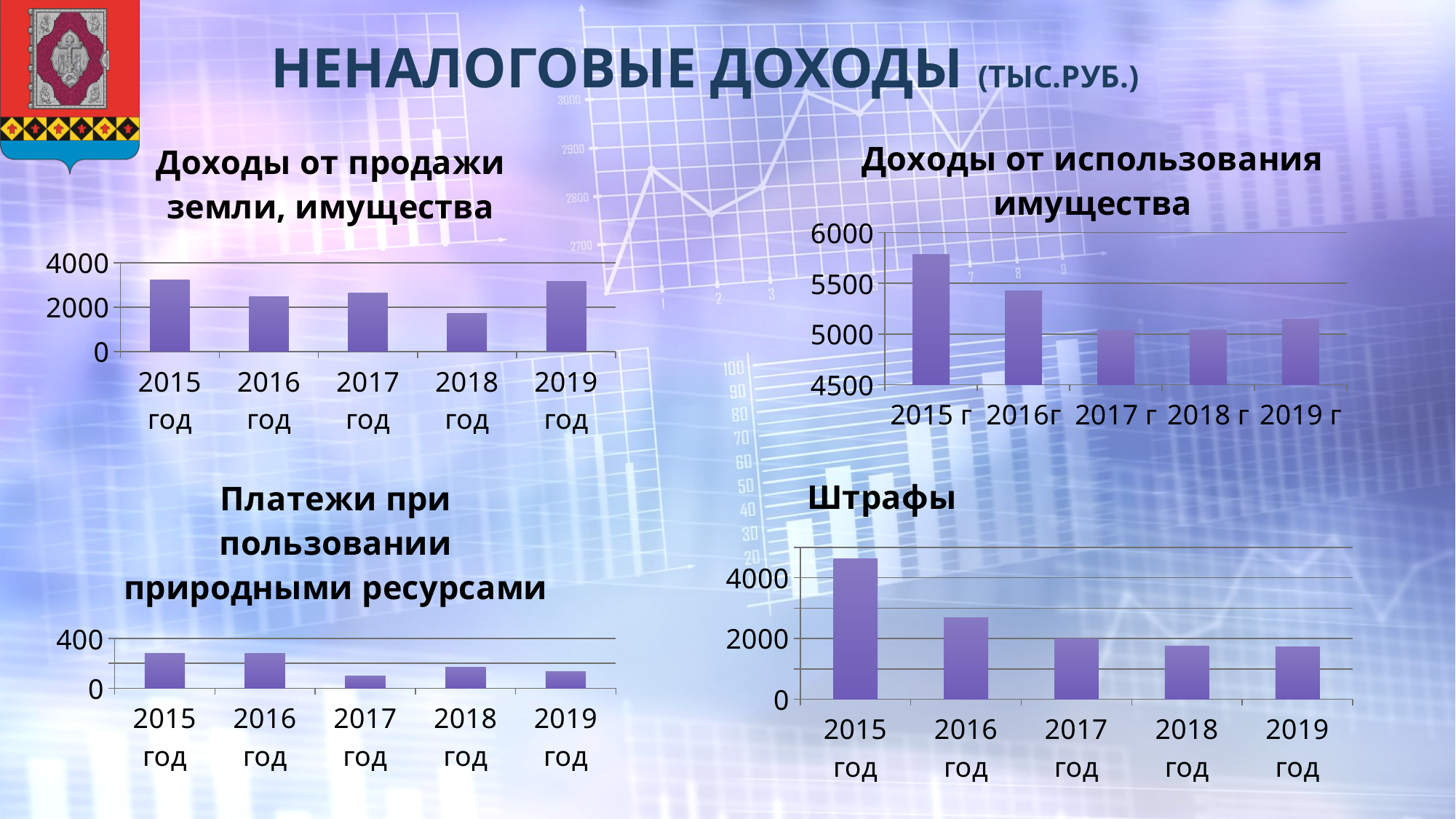
In the 'Доходы от использования имущества' chart, is the value for 2015 г greater or less than 5500? greater In the 'Доходы от использования имущества' chart, which year has the highest value? 2015 г In the 'Доходы от использования имущества' chart, which is larger, the value for 2016г or for 2019 г? 2016г What kind of chart is the 'Штрафы' chart? bar chart In the 'Штрафы' chart, is the value for 2018 год greater or less than 2000? less How many years are shown on the x axis of the 'Штрафы' chart? 5 In the 'Доходы от продажи земли, имущества' chart, is the value for 2018 год greater or less than 2000? less In the 'Платежи при пользовании природными ресурсами' chart, which year has the lowest value? 2017 год According to the slide title, in what units are the values shown? тыс.руб. In the 'Штрафы' chart, which year has the highest value? 2015 год In the 'Доходы от продажи земли, имущества' chart, which year has the lowest value? 2018 год